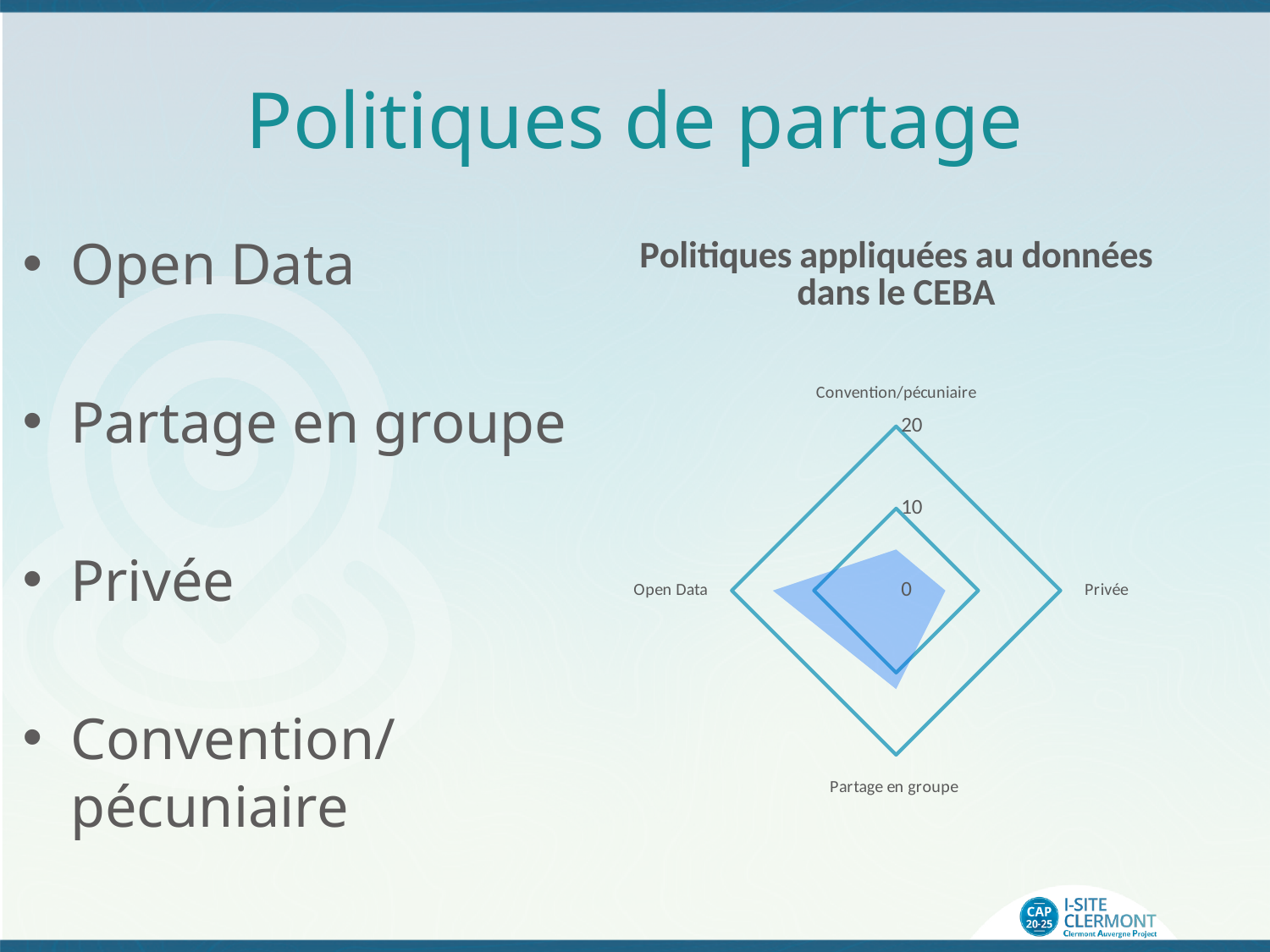
What is the maximum value shown on the chart's axis scale? 20 Is the value for Privée greater or less than 10? less Which category has the highest value in the chart? Open Data Which is larger, the value for Partage en groupe or the value for Privée? Partage en groupe What is the title of the chart? Politiques appliquées au données dans le CEBA Is the value for Open Data greater or less than 10? greater How many categories (axes) does the radar chart have? 4 Which is larger, the value for Open Data or the value for Partage en groupe? Open Data What kind of chart is shown on the slide? Radar chart Is the value for Convention/pécuniaire greater or less than 10? less Which is larger, the value for Open Data or the value for Privée? Open Data